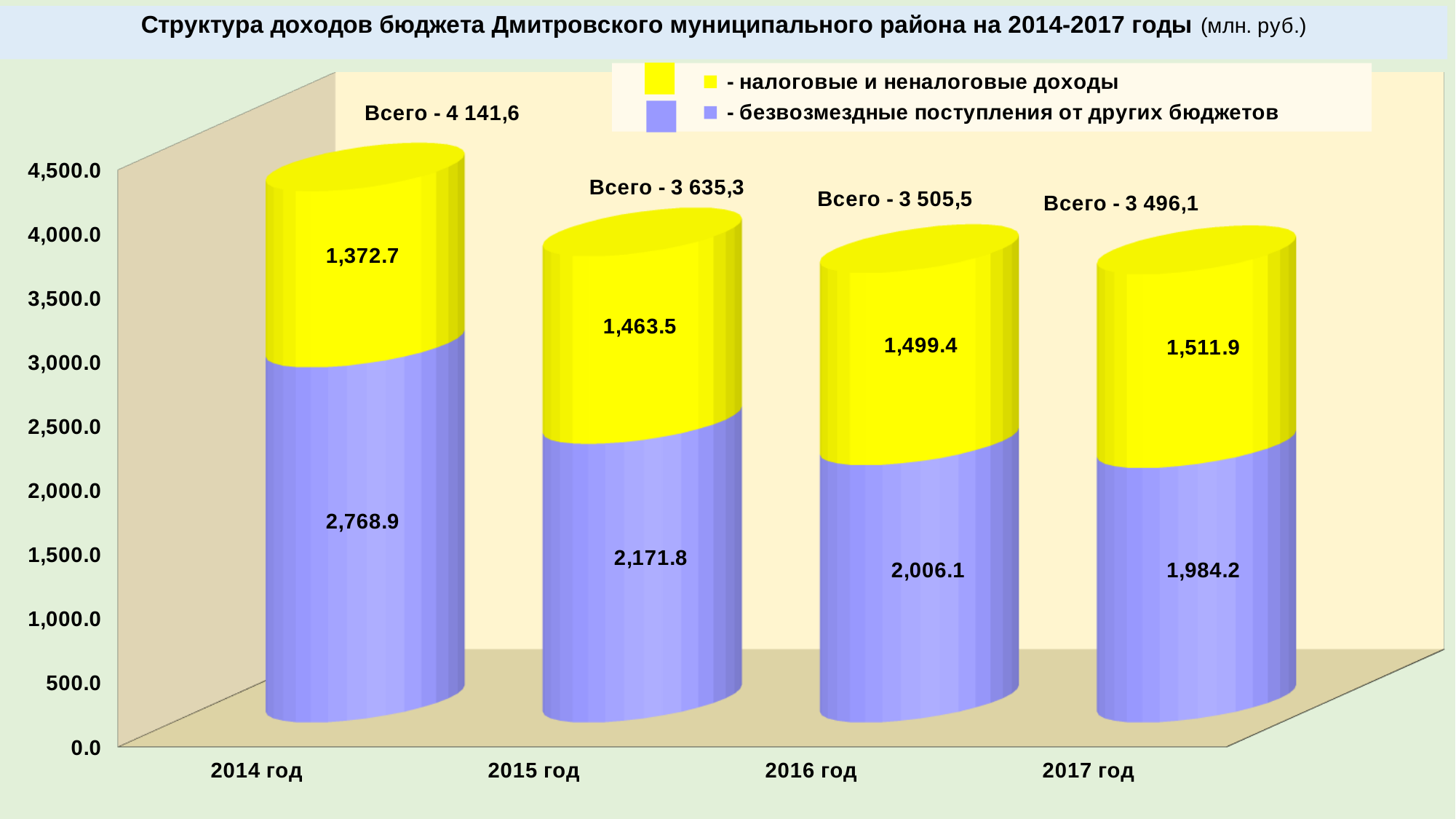
Which year has the lowest value of безвозмездные поступления от других бюджетов? 2017 год Do the values of безвозмездные поступления от других бюджетов rise or fall from 2014 год to 2017 год? Fall How many series does the legend list? 2 Which is larger: налоговые и неналоговые доходы in 2015 год or in 2016 год? 2016 год What is the total (Всего) for 2014 год? 4 141,6 What is the difference between безвозмездные поступления от других бюджетов in 2014 год and 2015 год? 597.1 How many years are shown on the x axis? 4 Which year has the highest value of налоговые и неналоговые доходы? 2017 год What kind of chart is shown on the slide? Stacked bar chart What is the value of безвозмездные поступления от других бюджетов for 2017 год? 1,984.2 What is the value of налоговые и неналоговые доходы for 2014 год? 1,372.7 Which year has the highest value of безвозмездные поступления от других бюджетов? 2014 год